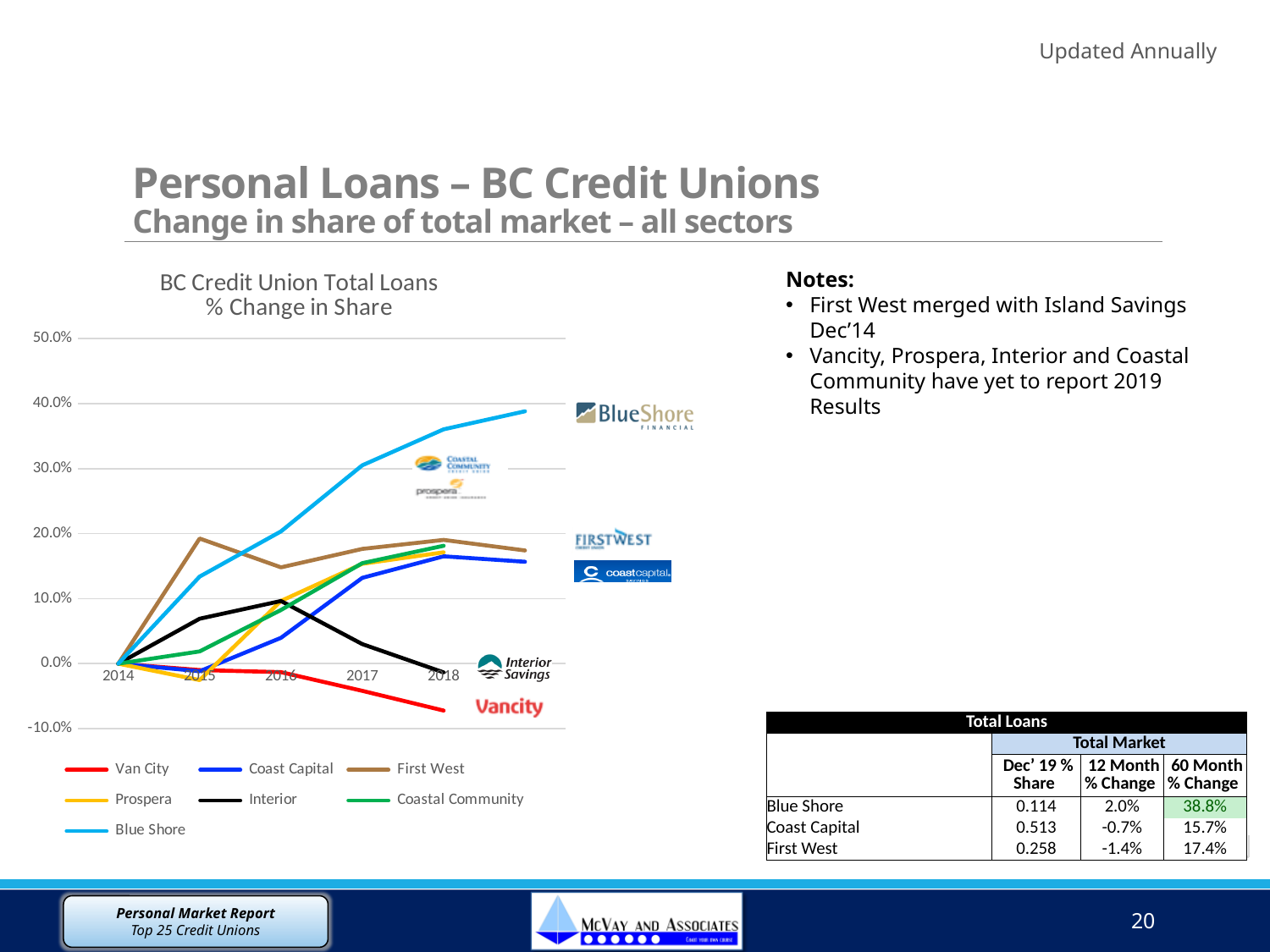
Does the Interior line rise or fall from 2016 to 2018? fall What kind of chart is shown on the slide? line chart How many years are labelled on the x axis of the chart? 5 In 2018, which is larger: the value for Coast Capital or the value for Van City? Coast Capital What is the title of the chart? BC Credit Union Total Loans % Change in Share How many series does the chart legend list? 7 Does the Blue Shore line rise or fall from 2014 to 2018? rise Is the value for Blue Shore in 2018 greater or less than 30.0%? greater Is the value for First West in 2015 greater or less than 10.0%? greater Which credit union has the lowest % change in share in 2018? Van City Is the value for Van City in 2018 greater or less than 0.0%? less Which credit union has the highest % change in share in 2018? Blue Shore